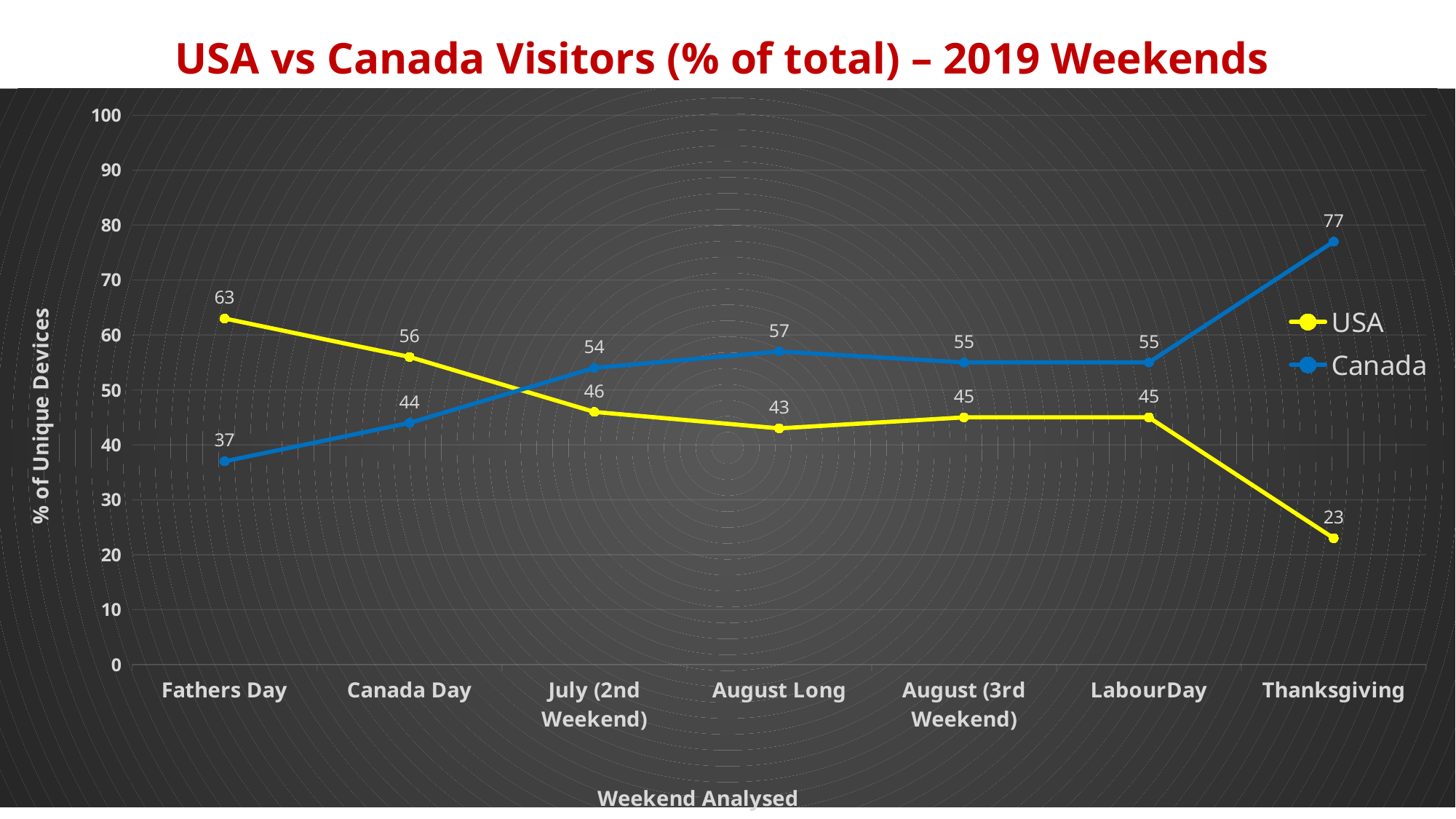
What is the Canada value for Canada Day? 44 What is the difference between the USA and Canada values for Fathers Day? 26 What is the USA value for Fathers Day? 63 Does the Canada series rise or fall from Fathers Day to Thanksgiving? Rise How many weekends are shown on the x axis? 7 For which weekend is the USA series lowest? Thanksgiving How many series does the legend list? 2 Which is larger on Canada Day, the USA value or the Canada value? USA What kind of chart is shown on the slide? Line chart For which weekend is the Canada series highest? Thanksgiving What is the USA value for August Long? 43 What is the Canada value for Thanksgiving? 77